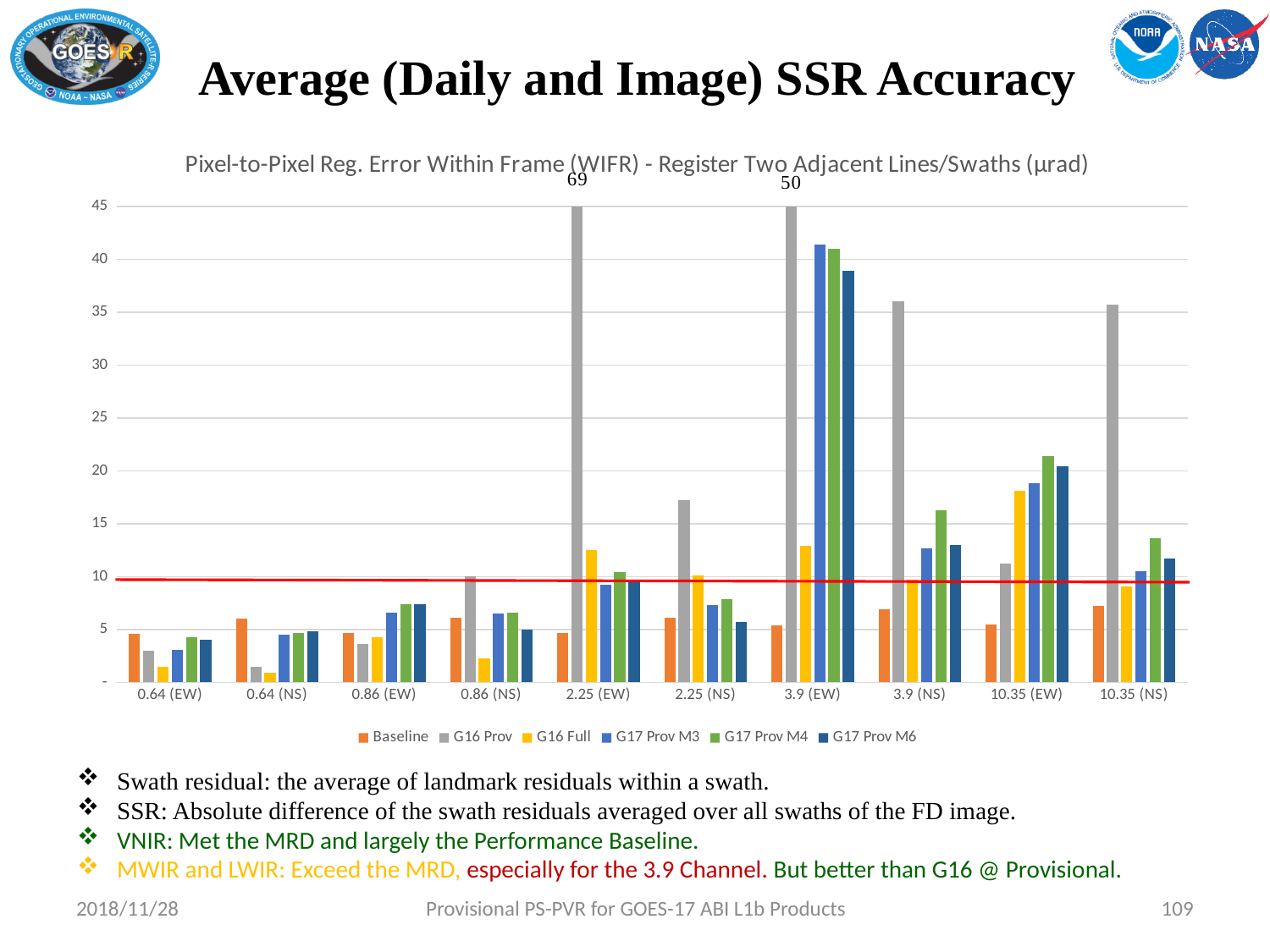
What is the difference between the G16 Prov values for 2.25 (EW) and 3.9 (EW)? 19 What is the first series listed in the chart's legend? Baseline Is the G16 Prov value for 10.35 (NS) greater or less than 30? greater For 10.35 (EW), which is larger: the Baseline value or the G17 Prov M4 value? G17 Prov M4 What is the G16 Prov value for 2.25 (EW)? 69 How many categories are shown along the x axis of the chart? 10 How many series does the chart's legend list? 6 Is the G17 Prov M3 value for 3.9 (EW) greater or less than 35? greater What kind of chart is shown on the slide? bar chart Which category has the highest G16 Prov value? 2.25 (EW) Which category has the lowest G16 Prov value? 0.64 (NS) What is the G16 Prov value for 3.9 (EW)? 50